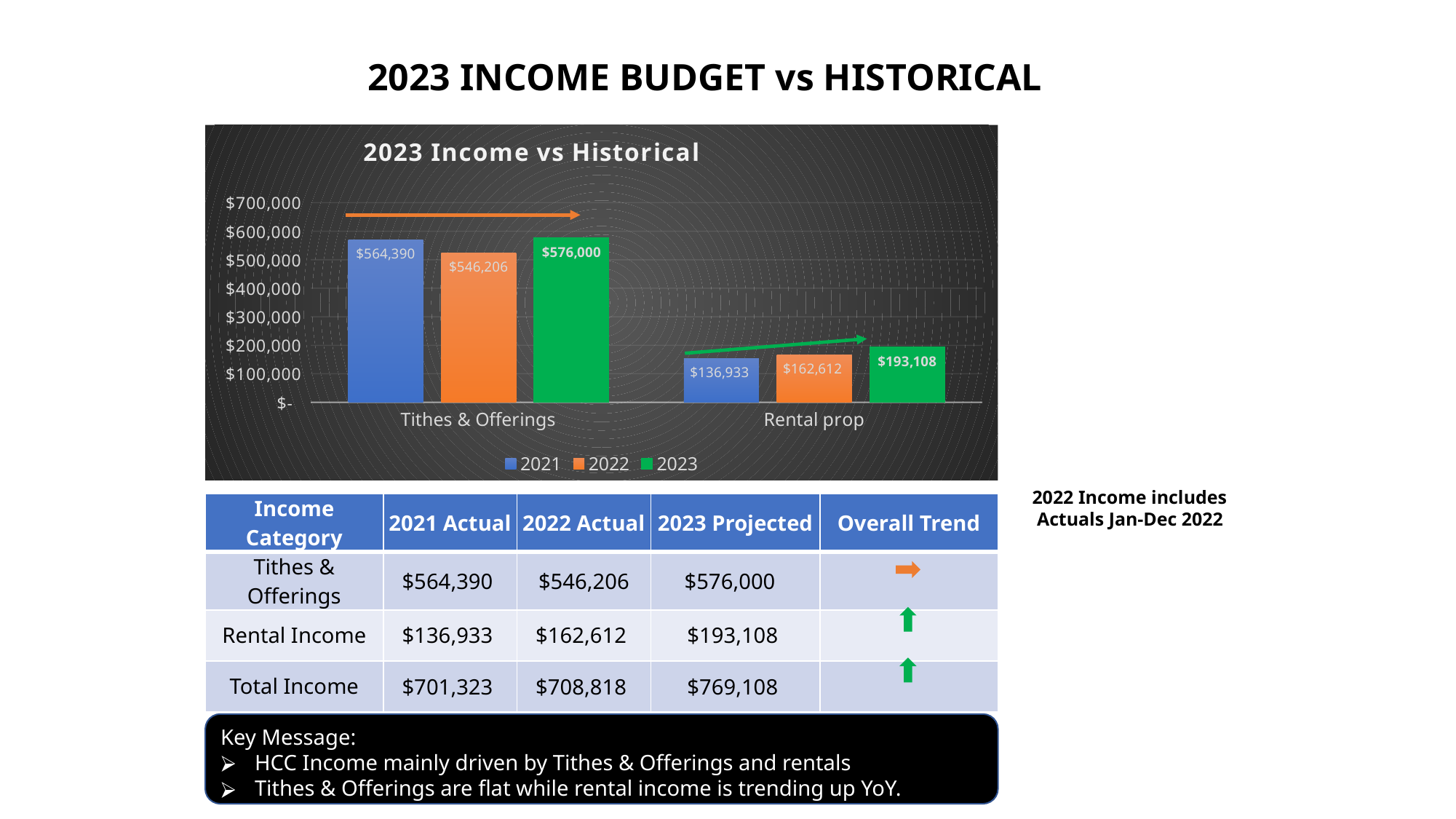
Which year has the highest value for Tithes & Offerings? 2023 What is the difference between the 2023 and 2022 values for Rental prop? $30,496 Which is larger: the 2021 value for Tithes & Offerings or the 2022 value for Tithes & Offerings? 2021 Is the 2022 value for Rental prop greater or less than $200,000? less How many series does the legend list? 3 What is the 2021 value for Tithes & Offerings? $564,390 What is the 2022 value for Tithes & Offerings? $546,206 What is the 2023 value for Rental prop? $193,108 How many categories are shown on the x axis? 2 Which year has the lowest value for Rental prop? 2021 Do the values for Rental prop rise or fall from 2021 to 2023? rise What kind of chart is shown? bar chart